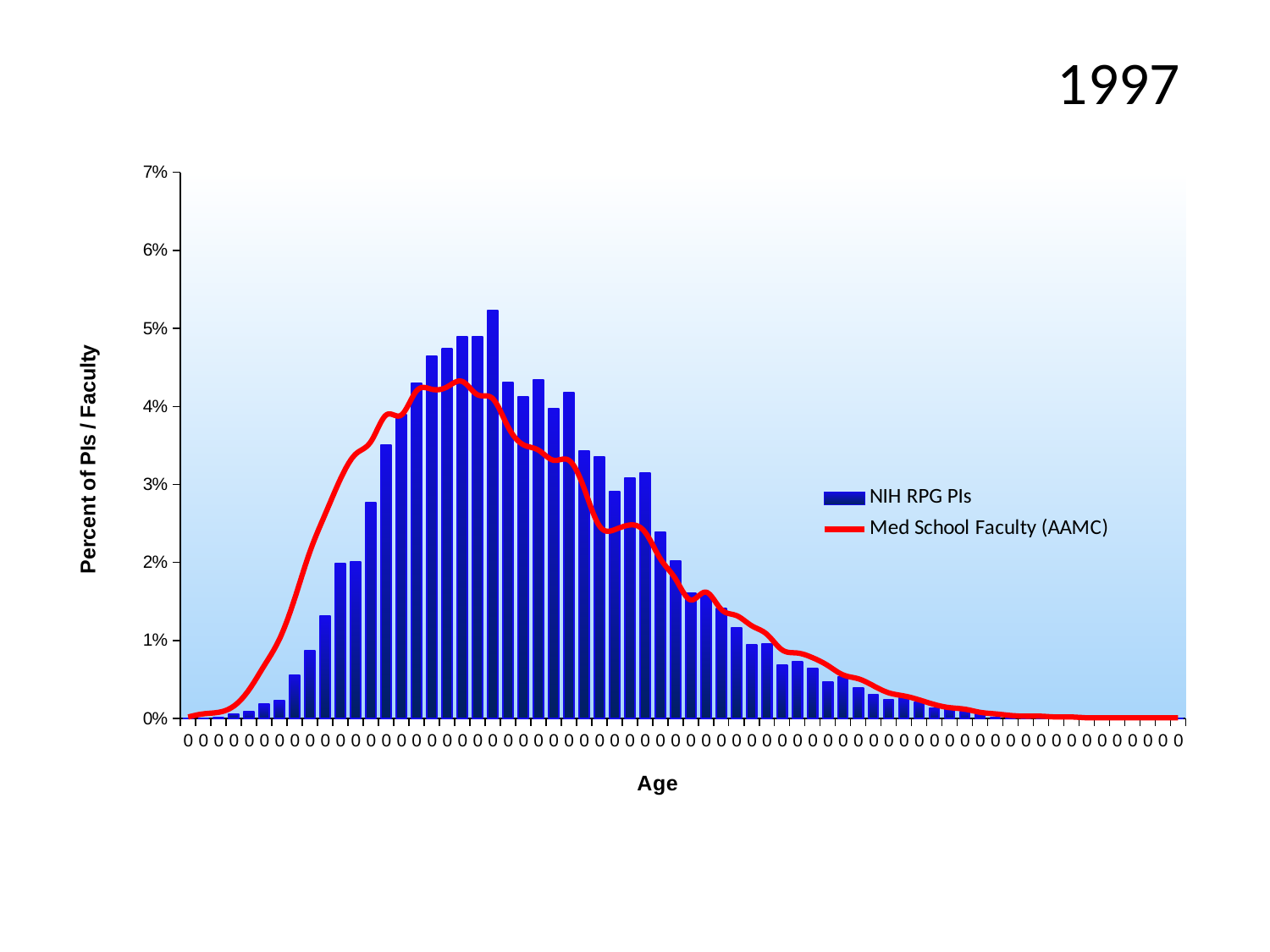
Which series reaches a higher peak value, NIH RPG PIs or Med School Faculty (AAMC)? NIH RPG PIs Which series is drawn as bars? NIH RPG PIs Is the tallest NIH RPG PIs bar greater or less than 5%? greater What is the highest value shown on the y axis? 7% What year is shown as the slide title? 1997 What kind of chart is this? A bar chart with an overlaid line Is the peak of the Med School Faculty (AAMC) line greater or less than 4%? greater Is the peak of the Med School Faculty (AAMC) line greater or less than 5%? less How many series does the legend list? 2